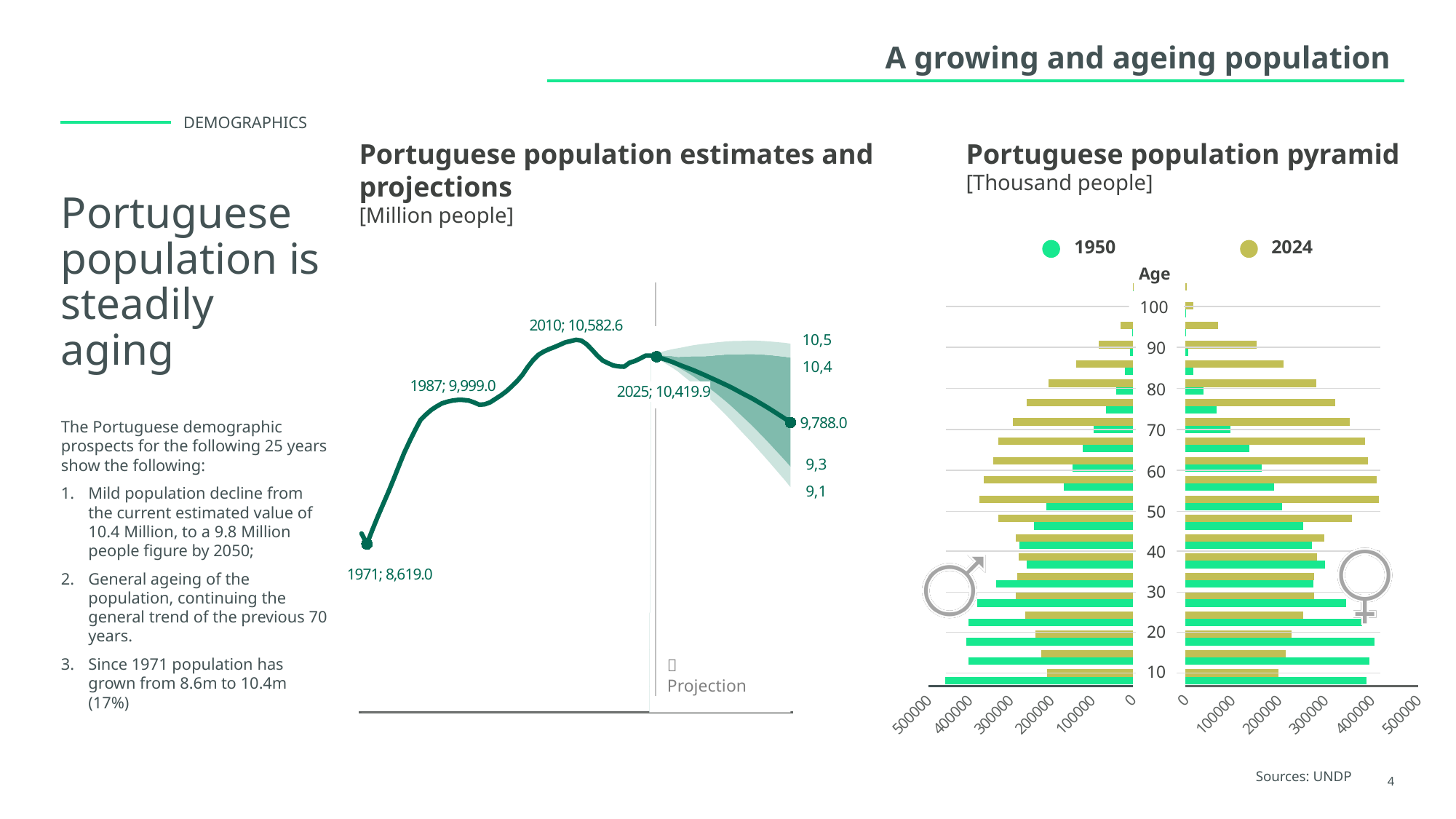
In the 'Portuguese population estimates and projections' chart, what value is labelled for 1987? 9,999.0 In the 'Portuguese population estimates and projections' chart, does the line rise or fall between 1971 and 2010? rise In the 'Portuguese population estimates and projections' chart, which labelled year has the highest value? 2010 What kind of chart is the 'Portuguese population pyramid'? bar chart How many series does the legend of the 'Portuguese population pyramid' chart list? 2 What are the two legend entries in the 'Portuguese population pyramid' chart? 1950 and 2024 In the 'Portuguese population estimates and projections' chart, which is larger: the 1987 value or the 2025 value? 2025 In the 'Portuguese population estimates and projections' chart, what value is labelled for 2025? 10,419.9 In the 'Portuguese population estimates and projections' chart, what value is labelled for 2010? 10,582.6 In the 'Portuguese population estimates and projections' chart, what value is labelled at the end of the projection line? 9,788.0 In the 'Portuguese population estimates and projections' chart, what is the difference between the 2010 value and the 1971 value? 1,963.6 In the 'Portuguese population estimates and projections' chart, what value is labelled for 1971? 8,619.0